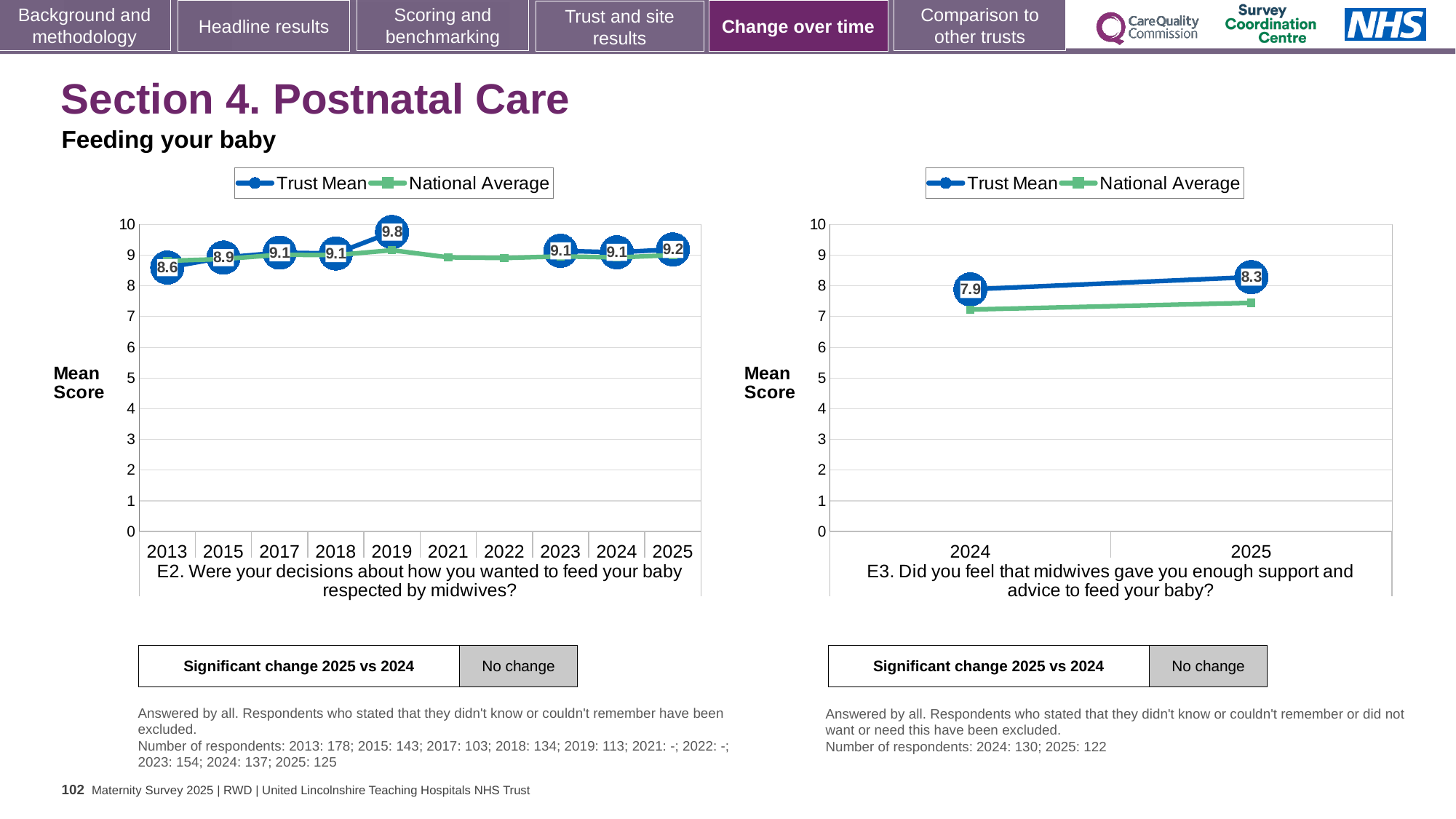
On the E2 chart (left), what is the Trust Mean for 2013? 8.6 On the E3 chart (right), what is the Trust Mean for 2025? 8.3 On the E3 chart (right), does the Trust Mean rise or fall from 2024 to 2025? rise On the E2 chart (left), how many years are shown on the x axis? 10 On the E3 chart (right), what is the Trust Mean for 2024? 7.9 On the E3 chart (right), is the National Average for 2025 greater or less than 8? less On the E2 chart (left), what is the Trust Mean for 2019? 9.8 On the E2 chart (left), which year has the lowest Trust Mean? 2013 On the E2 chart (left), what is the difference between the Trust Mean in 2019 and in 2013? 1.2 On the E2 chart (left), what is the Trust Mean for 2025? 9.2 How many series does the legend of the E3 chart (right) list? 2 On the E2 chart (left), which year has the highest Trust Mean? 2019